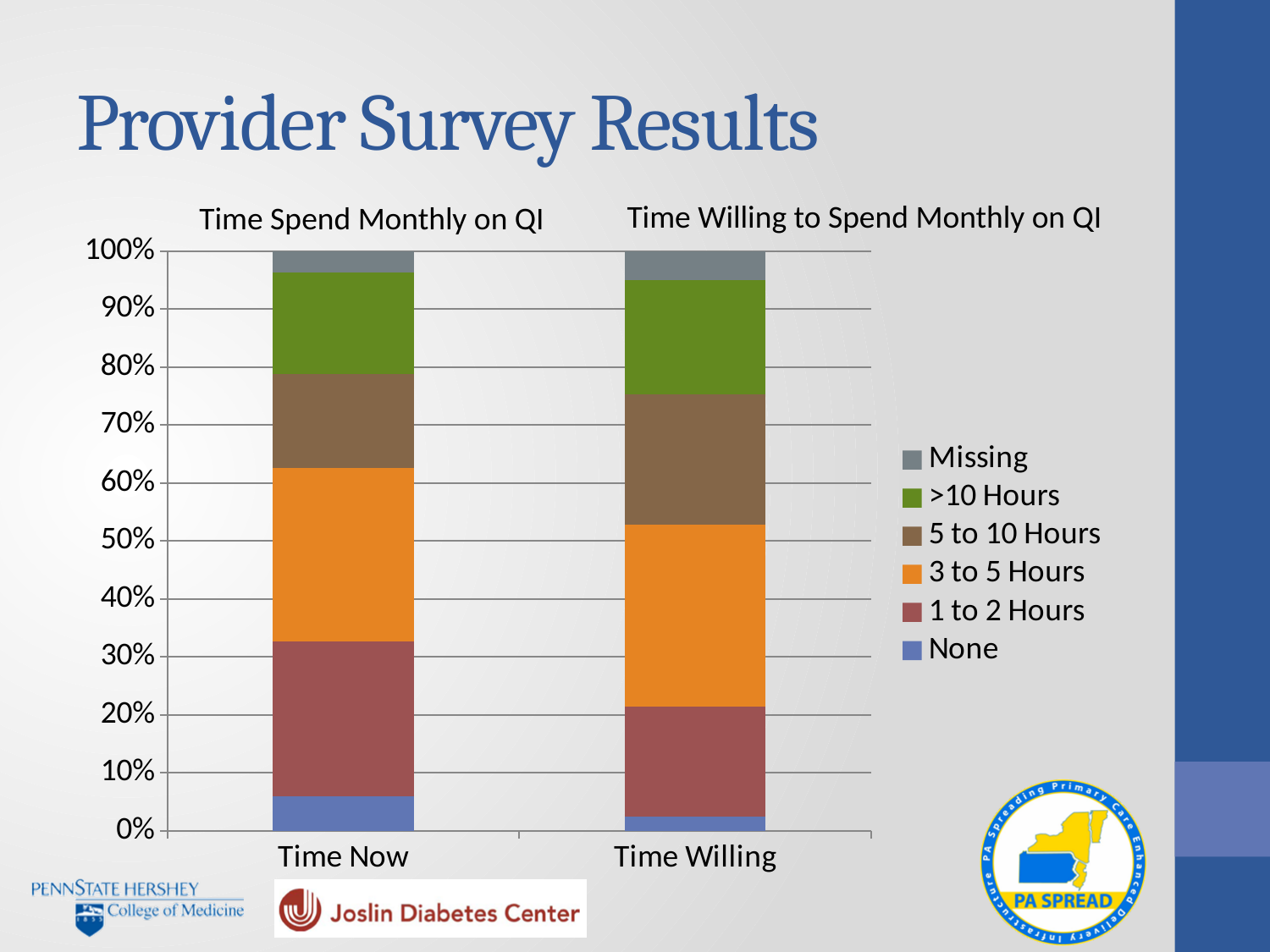
Is the 1 to 2 Hours segment for Time Willing greater or less than 10%? greater What kind of chart is shown on the slide? Stacked bar chart What are the two category labels on the x axis? Time Now and Time Willing Which bar has the larger None segment, Time Now or Time Willing? Time Now Which legend entry is shown in orange? 3 to 5 Hours Which series has the largest segment in the Time Willing bar? 3 to 5 Hours Which bar has the larger 5 to 10 Hours segment, Time Now or Time Willing? Time Willing What is the total height of the Time Now stacked bar? 100% Is the 1 to 2 Hours segment for Time Now greater or less than 20%? greater Is the None segment for Time Now greater or less than 10%? less How many bars (categories) are plotted on the x axis? 2 How many series does the legend list? 6